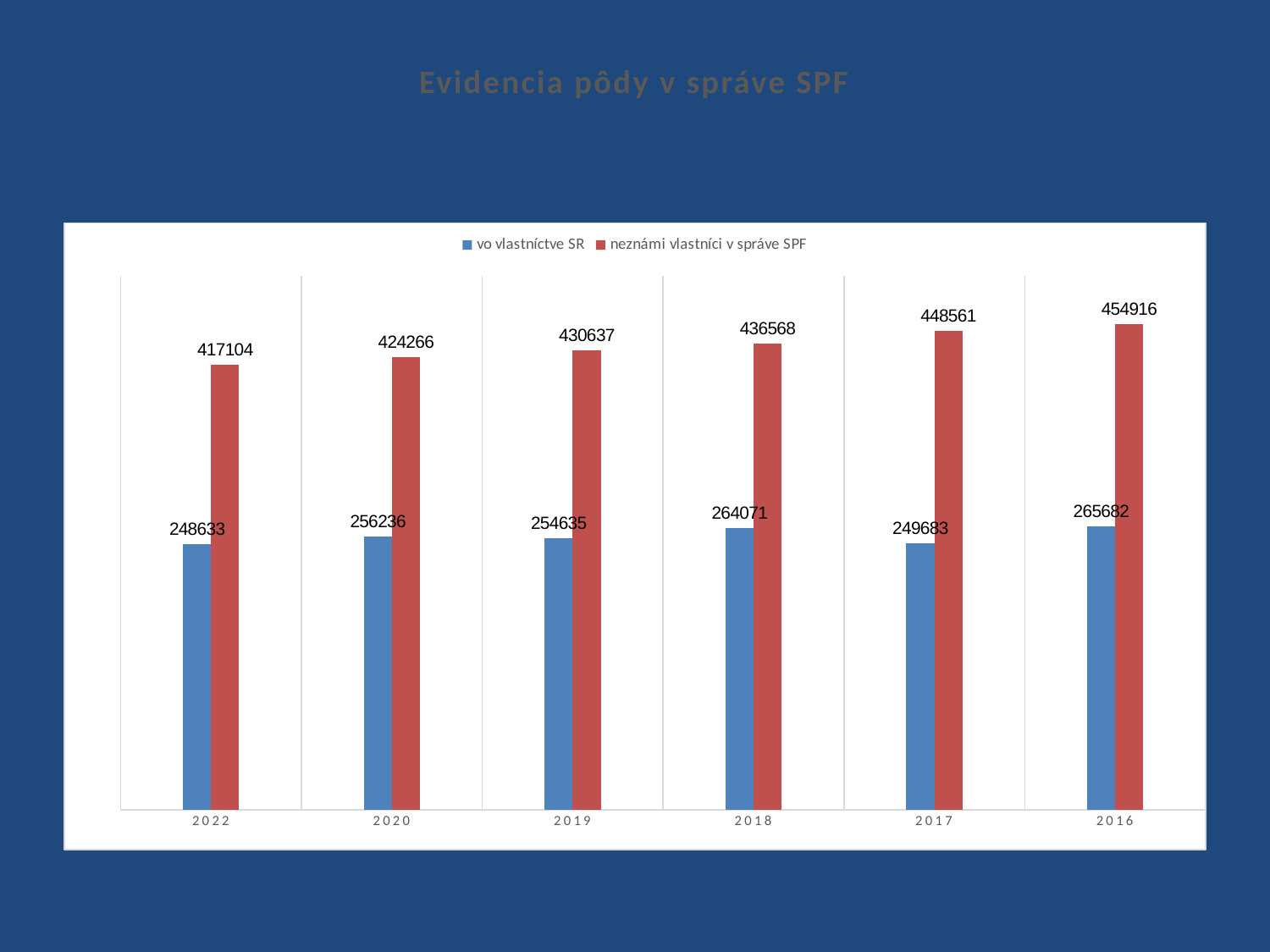
How many year categories are shown on the x axis? 6 What is the value for 'neznámi vlastníci v správe SPF' in 2017? 448561 Which colour represents the series 'vo vlastníctve SR'? blue What is the value for 'neznámi vlastníci v správe SPF' in 2022? 417104 What is the value for 'vo vlastníctve SR' in 2018? 264071 What type of chart is shown on the slide? bar chart Which year has the lowest value for 'vo vlastníctve SR'? 2022 Which year has the highest value for 'neznámi vlastníci v správe SPF'? 2016 How many series does the legend list? 2 Which is larger in 2019: 'vo vlastníctve SR' or 'neznámi vlastníci v správe SPF'? neznámi vlastníci v správe SPF What is the difference between 'neznámi vlastníci v správe SPF' and 'vo vlastníctve SR' in 2022? 168471 Do the values for 'neznámi vlastníci v správe SPF' rise or fall from left to right along the x axis? rise